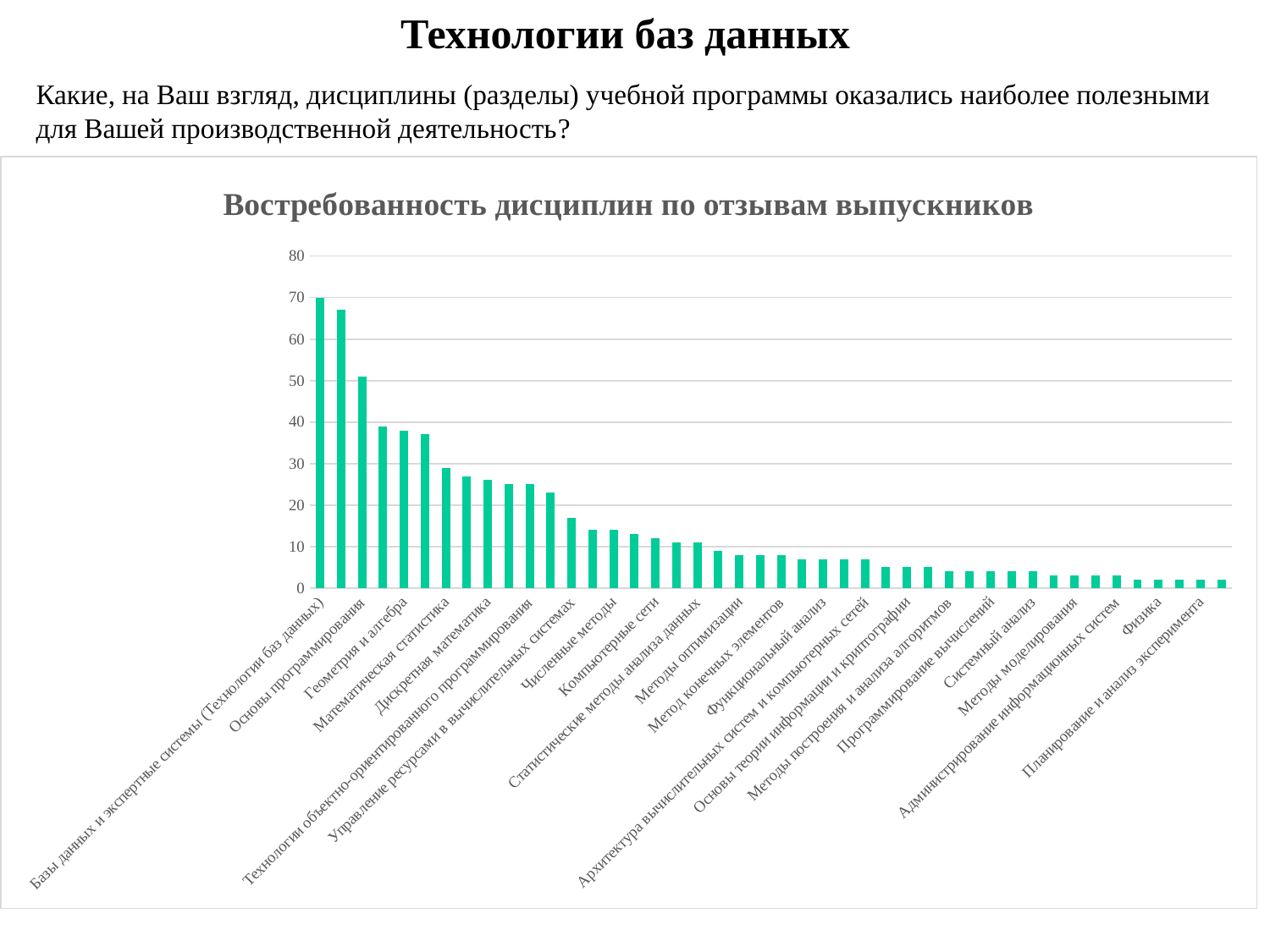
Is the value for Физика greater or less than 10? less Is the value for Планирование и анализ эксперимента greater or less than 10? less What is the title of the chart? Востребованность дисциплин по отзывам выпускников Which has the larger value: Основы программирования or Геометрия и алгебра? Основы программирования Is the value for Базы данных и экспертные системы (Технологии баз данных) greater or less than 60? greater Do the values rise or fall from left to right along the x axis? fall Which discipline has the highest value in the chart? Базы данных и экспертные системы (Технологии баз данных) Which has the larger value: Численные методы or Системный анализ? Численные методы What kind of chart is shown on the slide? bar chart